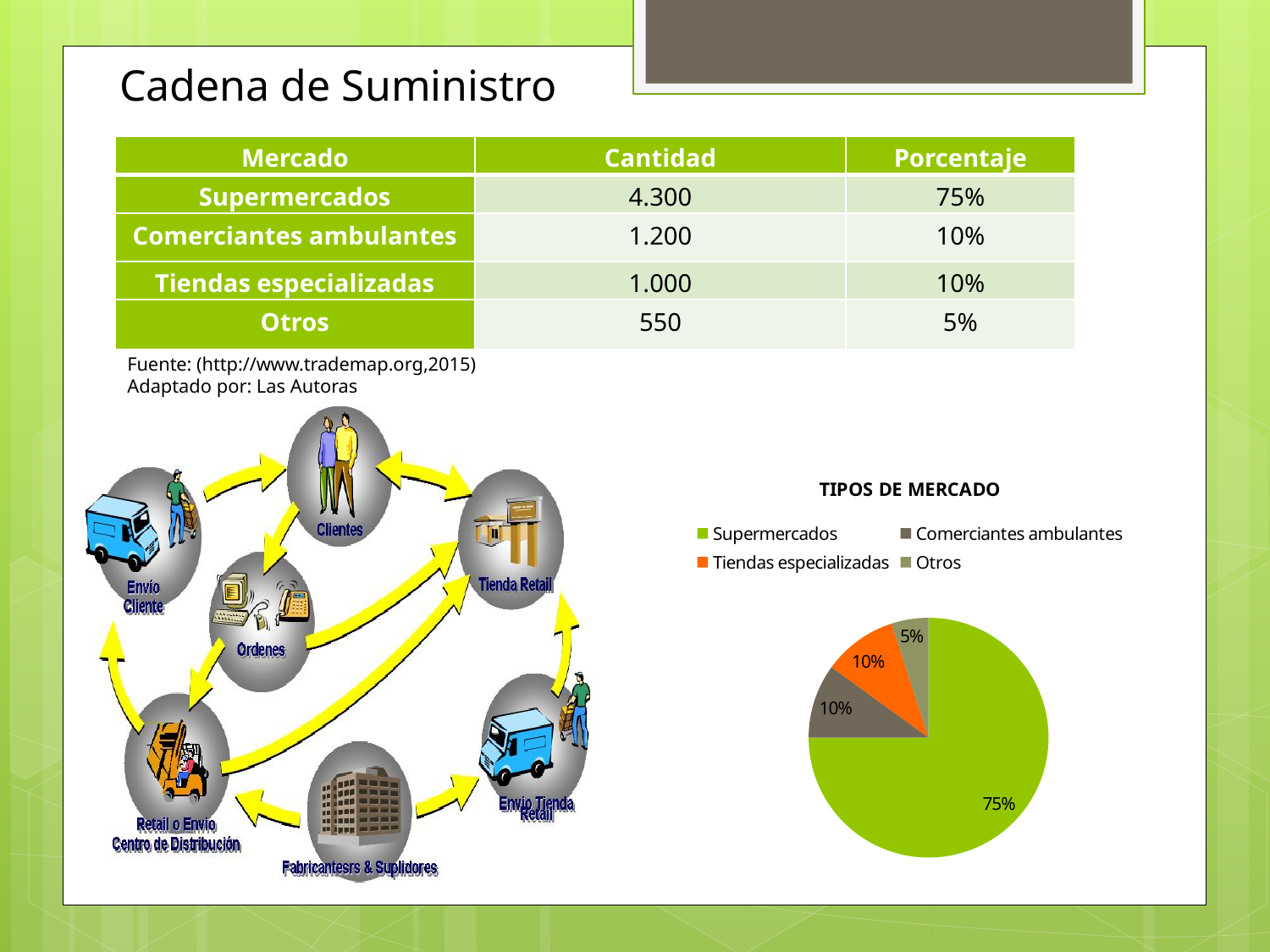
In the TIPOS DE MERCADO pie chart, what share does Comerciantes ambulantes have? 10% Which category has the largest slice in the TIPOS DE MERCADO pie chart? Supermercados What kind of chart is shown under the title TIPOS DE MERCADO? Pie chart In the TIPOS DE MERCADO pie chart, which is larger, the Supermercados slice or the Tiendas especializadas slice? Supermercados Which category has the smallest slice in the TIPOS DE MERCADO pie chart? Otros In the TIPOS DE MERCADO pie chart, what share does Otros have? 5% How many slices does the TIPOS DE MERCADO pie chart have? 4 In the TIPOS DE MERCADO pie chart, what is the difference in percentage points between Supermercados and Otros? 70 In the TIPOS DE MERCADO pie chart, what share does Tiendas especializadas have? 10% How many entries does the legend of the TIPOS DE MERCADO pie chart list? 4 What is the title of the pie chart on the slide? TIPOS DE MERCADO